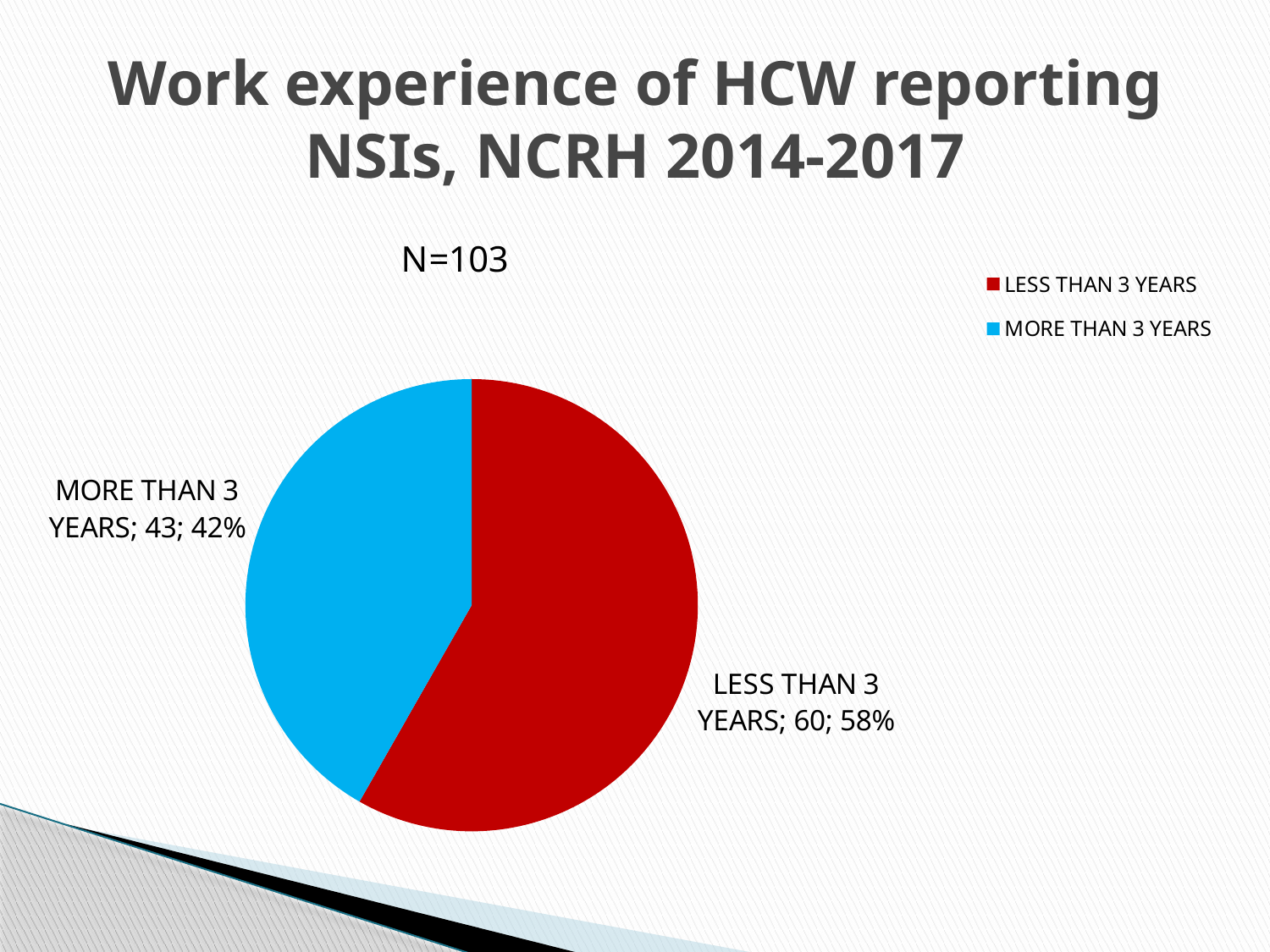
Which is larger: the count for 'LESS THAN 3 YEARS' or for 'MORE THAN 3 YEARS'? LESS THAN 3 YEARS How many categories does the pie chart have? 2 How many HCW reporting NSIs had less than 3 years of work experience? 60 How many HCW reporting NSIs had more than 3 years of work experience? 43 What is the total N shown for the chart? N=103 Which category has the largest slice of the pie? LESS THAN 3 YEARS What colour is the 'MORE THAN 3 YEARS' slice? blue What share of the pie does the 'LESS THAN 3 YEARS' slice represent? 58% What kind of chart is shown on the slide? pie chart What share of the pie does the 'MORE THAN 3 YEARS' slice represent? 42% What is the difference in count between the 'LESS THAN 3 YEARS' and 'MORE THAN 3 YEARS' categories? 17 Which category has the smallest slice of the pie? MORE THAN 3 YEARS